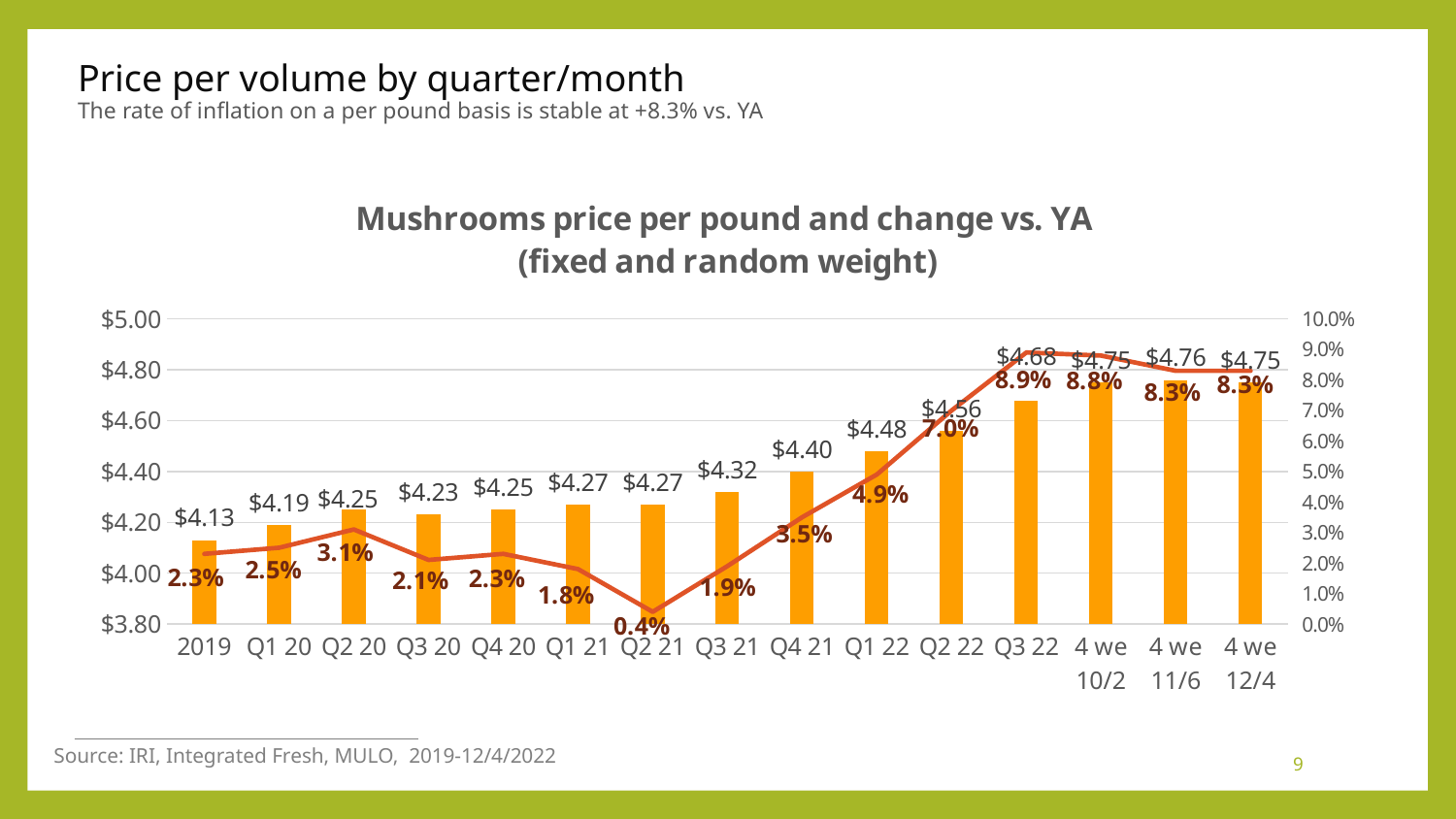
What is the mushrooms price per pound for Q4 21? $4.40 What is the price per pound for the 4 we 11/6 period? $4.76 What kind of chart is used to show the price per pound? Bar chart Do the price per pound bars generally rise or fall from 2019 to Q3 22? Rise Which period has the lowest change vs. YA? Q2 21 Which period has the highest change vs. YA? Q3 22 What is the difference in price per pound between Q1 22 and Q1 21? $0.21 What is the change vs. YA shown for Q2 22? 7.0% How many periods are shown on the x axis? 15 What is the title of the chart? Mushrooms price per pound and change vs. YA (fixed and random weight) Which is larger, the change vs. YA for Q1 22 or for Q4 21? Q1 22 Which period has the lowest price per pound? 2019